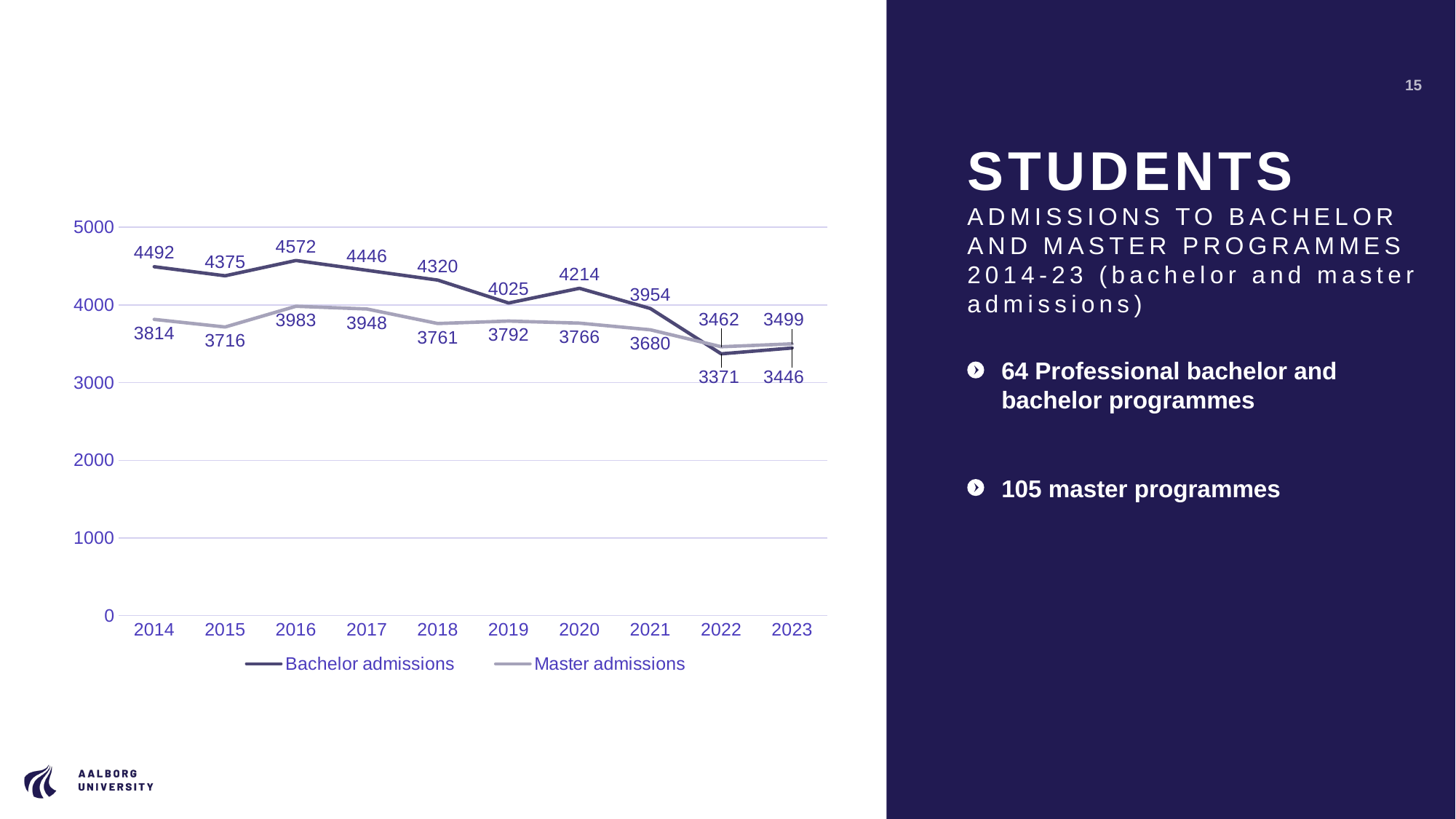
In which year were Bachelor admissions lowest? 2022 In which year were Bachelor admissions highest? 2016 In which year were Master admissions lowest? 2022 What was the number of Bachelor admissions in 2016? 4572 How many years are shown on the x axis? 10 Do Bachelor admissions generally rise or fall from 2014 to 2023? Fall Is the value for Master admissions in 2016 greater or less than 4000? less What type of chart is shown on the slide? Line chart What is the difference between Bachelor admissions and Master admissions in 2014? 678 What was the number of Master admissions in 2021? 3680 How many series does the legend list? 2 Which was larger in 2023, Bachelor admissions or Master admissions? Master admissions